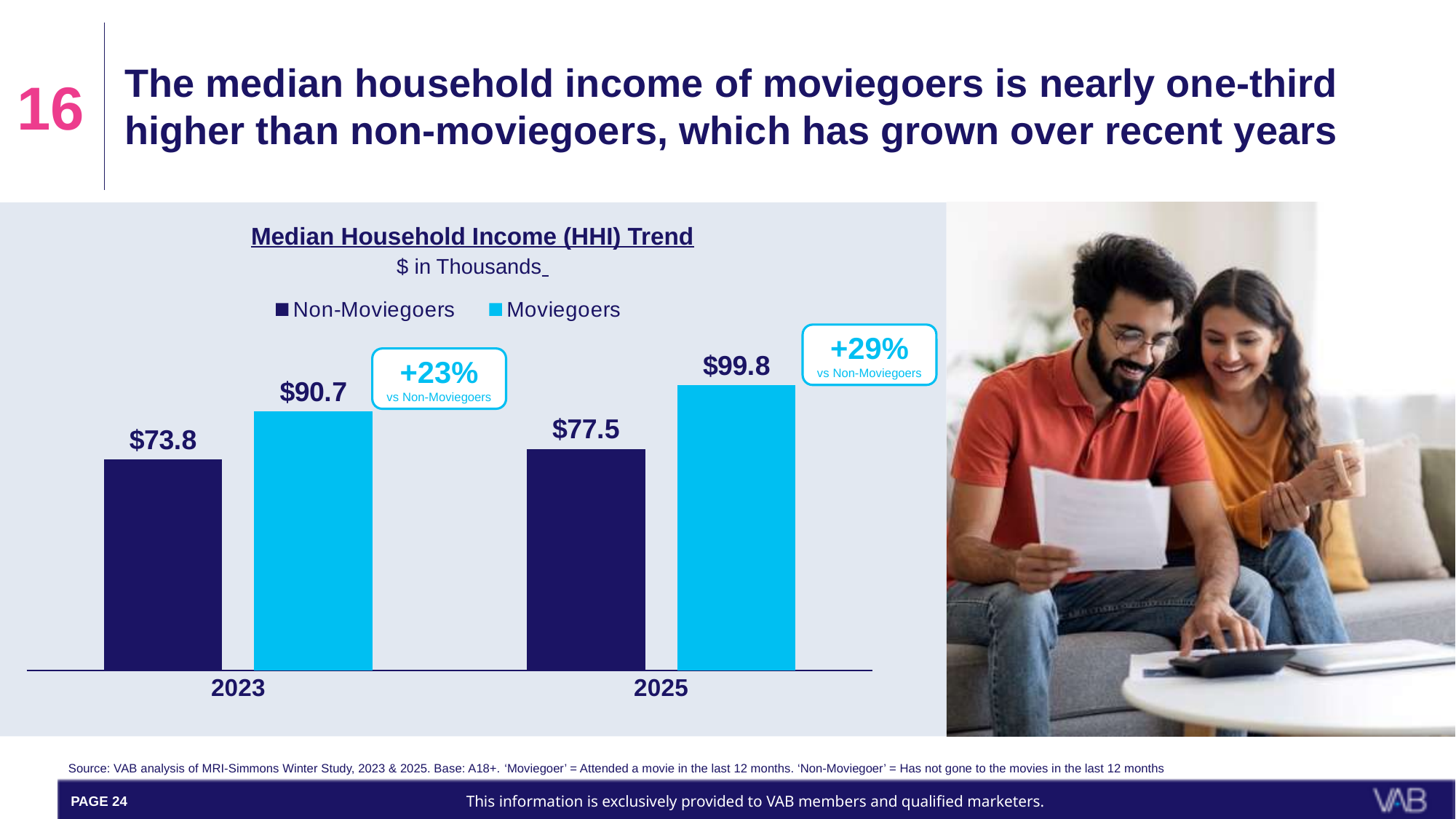
Do the Non-Moviegoers values rise or fall from 2023 to 2025? Rise Which bar has the lowest value on the chart? Non-Moviegoers in 2023 Which bar has the highest value on the chart? Moviegoers in 2025 What is the median household income for Non-Moviegoers in 2023? $73.8 What kind of chart is shown on the slide? Bar chart What is the value for Non-Moviegoers in 2025? $77.5 What is the value for Moviegoers in 2023? $90.7 How many series does the legend list? 2 What is the median household income for Moviegoers in 2025? $99.8 What is the difference between Moviegoers and Non-Moviegoers in 2025? $22.3 By how much did the Moviegoers value increase from 2023 to 2025? $9.1 Which is larger in 2023, Moviegoers or Non-Moviegoers? Moviegoers